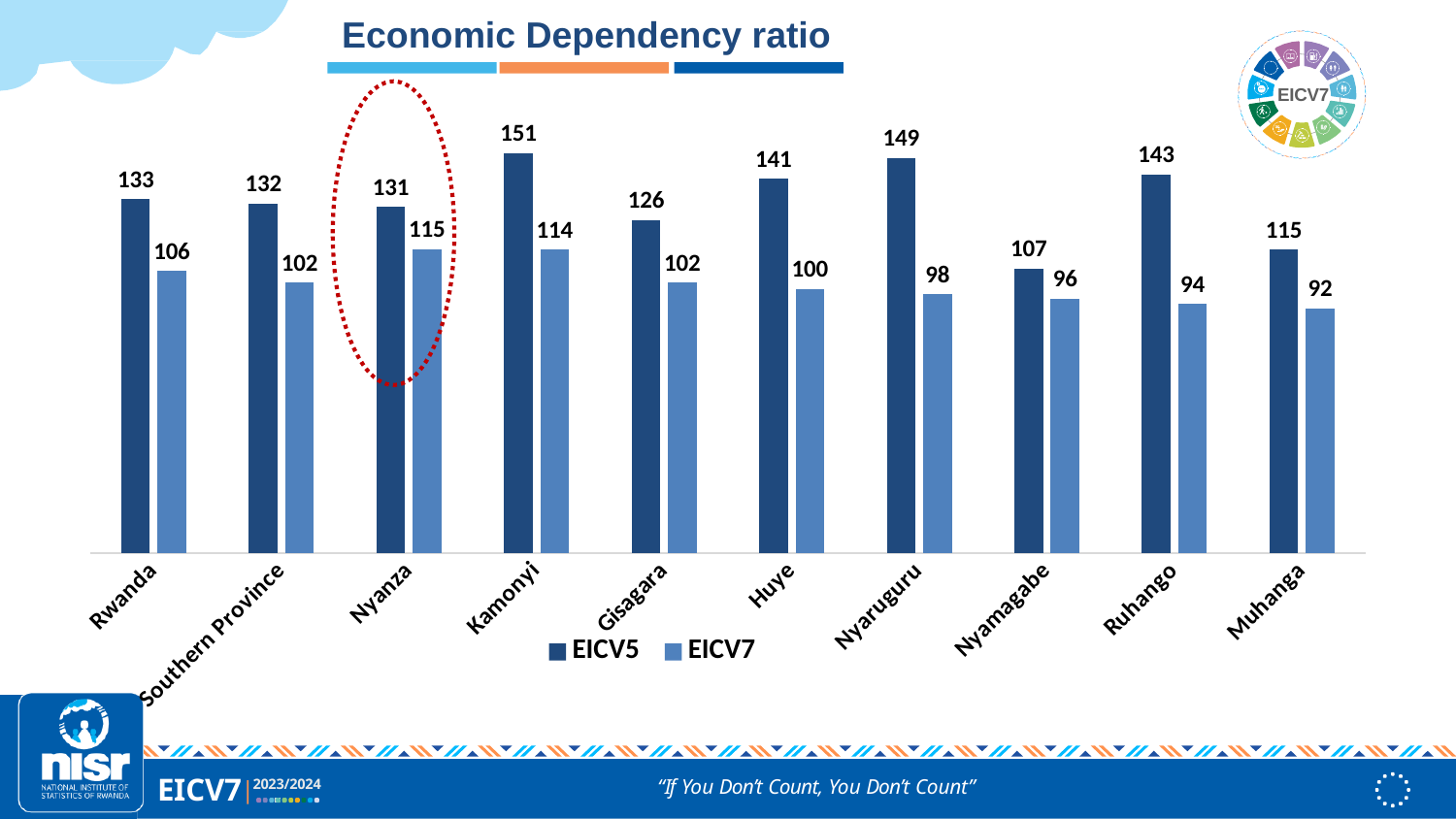
What is the EICV7 value for Nyanza? 115 What kind of chart is shown on the slide? Bar chart How many series does the legend list? 2 What is the difference between the EICV5 and EICV7 values for Ruhango? 49 How many categories are shown on the x axis? 10 What is the EICV5 value for Kamonyi? 151 Which category has the lowest EICV7 value? Muhanga What is the title of the chart? Economic Dependency ratio What is the EICV7 value for Rwanda? 106 Which category has the lowest EICV5 value? Nyamagabe Which category has the highest EICV5 value? Kamonyi Which is larger, the EICV7 value for Nyanza or the EICV7 value for Kamonyi? Nyanza